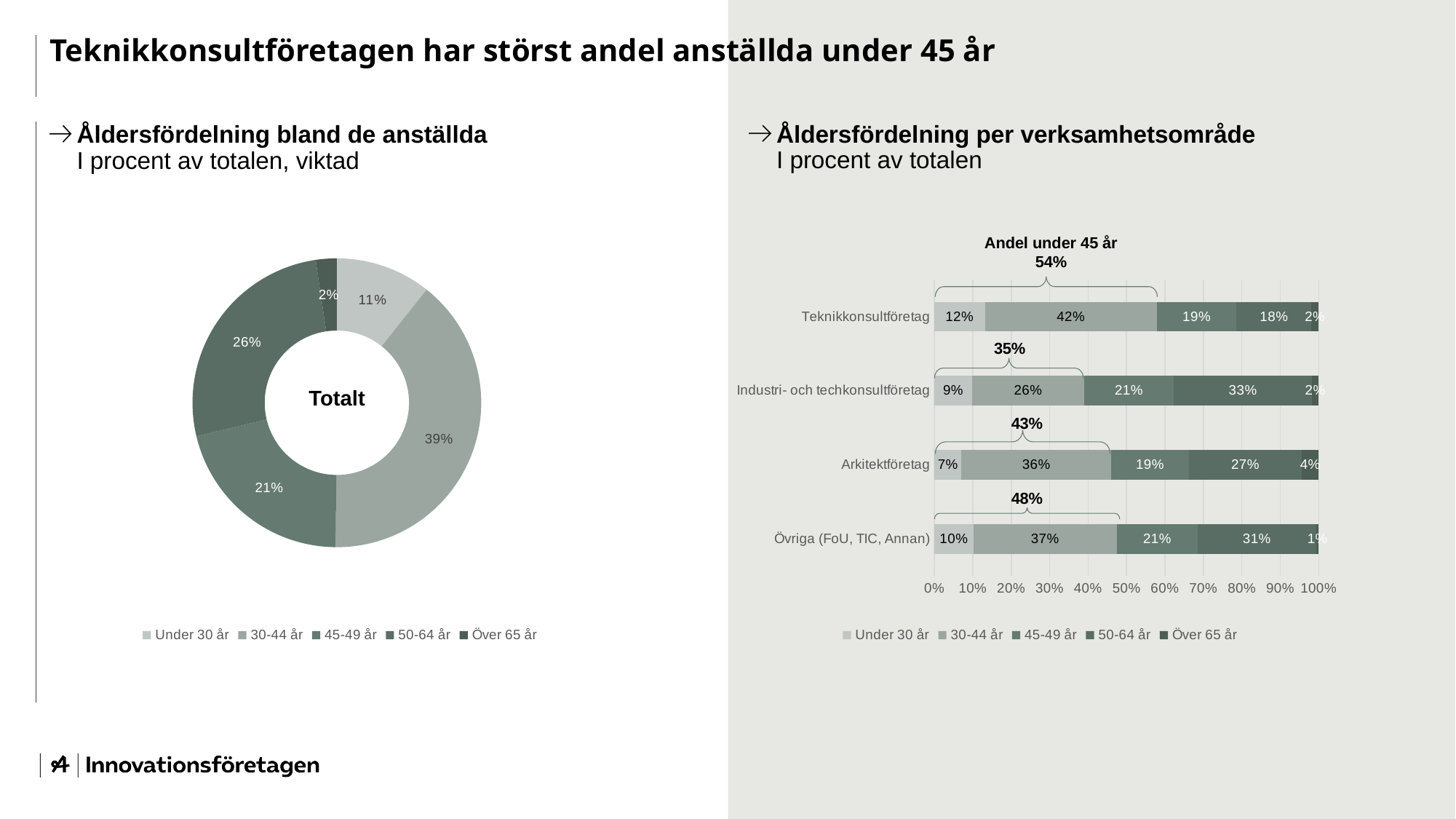
In the 'Åldersfördelning per verksamhetsområde' chart, what is the 30-44 år value for Teknikkonsultföretag? 42% How many series does the legend of the 'Åldersfördelning per verksamhetsområde' chart list? 5 In the 'Åldersfördelning bland de anställda' chart, which age group has the smallest share? Över 65 år In the 'Åldersfördelning bland de anställda' chart, what share of employees are Över 65 år? 2% In the 'Åldersfördelning bland de anställda' chart, what share of employees are 30-44 år? 39% In the 'Åldersfördelning per verksamhetsområde' chart, what is the 50-64 år value for Industri- och techkonsultföretag? 33% In the 'Åldersfördelning per verksamhetsområde' chart, what is the Under 30 år value for Arkitektföretag? 7% What kind of chart is 'Åldersfördelning bland de anställda'? Donut (pie) chart In the 'Åldersfördelning bland de anställda' chart, which age group has the largest share? 30-44 år How many categories are shown in the 'Åldersfördelning per verksamhetsområde' chart? 4 In the 'Åldersfördelning per verksamhetsområde' chart, what is the difference between the 30-44 år values for Teknikkonsultföretag and Industri- och techkonsultföretag? 16 percentage points In the 'Åldersfördelning per verksamhetsområde' chart, which category has the highest share under 45 år? Teknikkonsultföretag